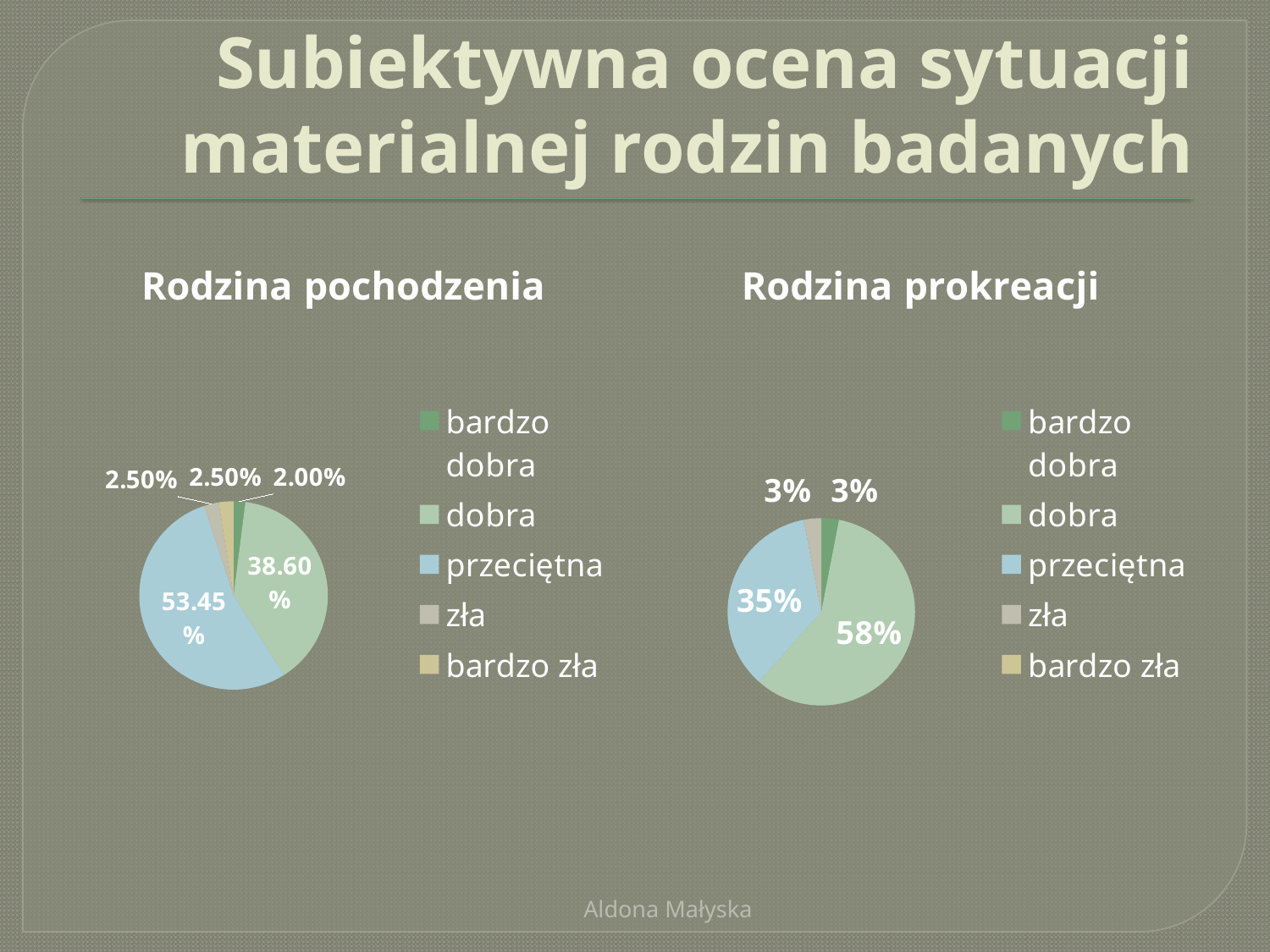
How many entries does the legend of the 'Rodzina prokreacji' chart list? 5 In the 'Rodzina pochodzenia' chart, which category has the largest share? przeciętna In the 'Rodzina pochodzenia' chart, what is the difference between 'przeciętna' and 'dobra'? 14.85% In the 'Rodzina prokreacji' chart, what is the value for 'dobra'? 58% What kind of chart is used for 'Rodzina pochodzenia'? pie chart In the 'Rodzina pochodzenia' chart, what is the value for 'dobra'? 38.60% In the 'Rodzina pochodzenia' chart, which category has the smallest share? bardzo dobra In the 'Rodzina prokreacji' chart, what is the value for 'przeciętna'? 35% In the 'Rodzina prokreacji' chart, which is larger, 'dobra' or 'przeciętna'? dobra In the 'Rodzina prokreacji' chart, which category has the largest share? dobra In the 'Rodzina pochodzenia' chart, what is the value for 'przeciętna'? 53.45% In the 'Rodzina pochodzenia' chart, what is the value for 'bardzo dobra'? 2.00%